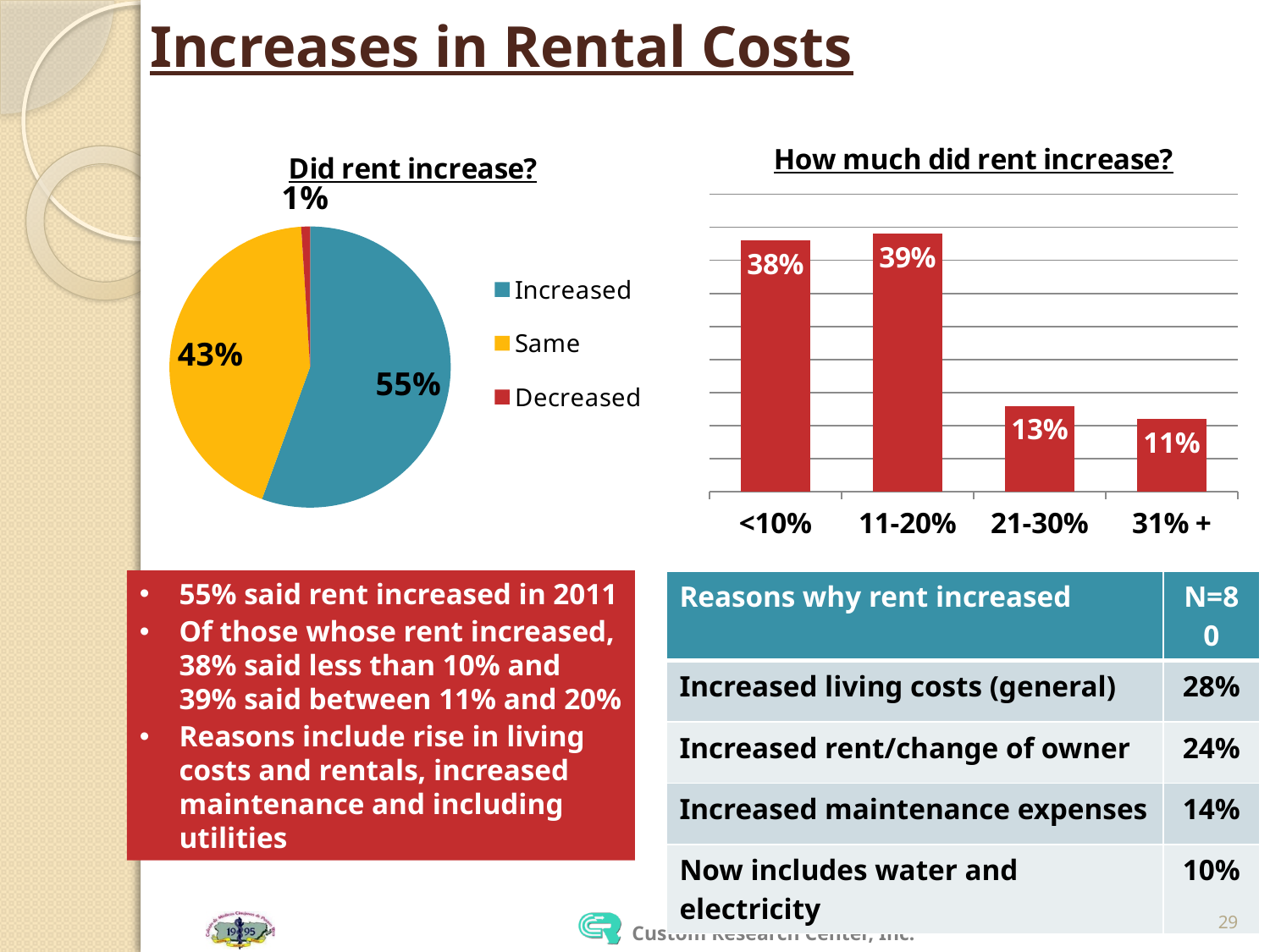
What kind of chart is 'How much did rent increase?' Bar chart In the 'Did rent increase?' chart, what is the difference between the Increased and Same shares? 12% In the 'Did rent increase?' chart, which category has the smallest slice? Decreased In the 'How much did rent increase?' chart, how many categories are shown on the x axis? 4 In the 'How much did rent increase?' chart, what is the difference between the <10% and 21-30% values? 25% In the 'How much did rent increase?' chart, what is the value for 11-20%? 39% In the 'Did rent increase?' chart, how many entries does the legend list? 3 In the 'How much did rent increase?' chart, what is the value for 31% +? 11% In the 'How much did rent increase?' chart, which category has the highest value? 11-20% In the 'Did rent increase?' chart, what share of respondents said rent increased? 55% In the 'Did rent increase?' chart, what share of respondents said rent stayed the same? 43% What kind of chart is 'Did rent increase?' Pie chart